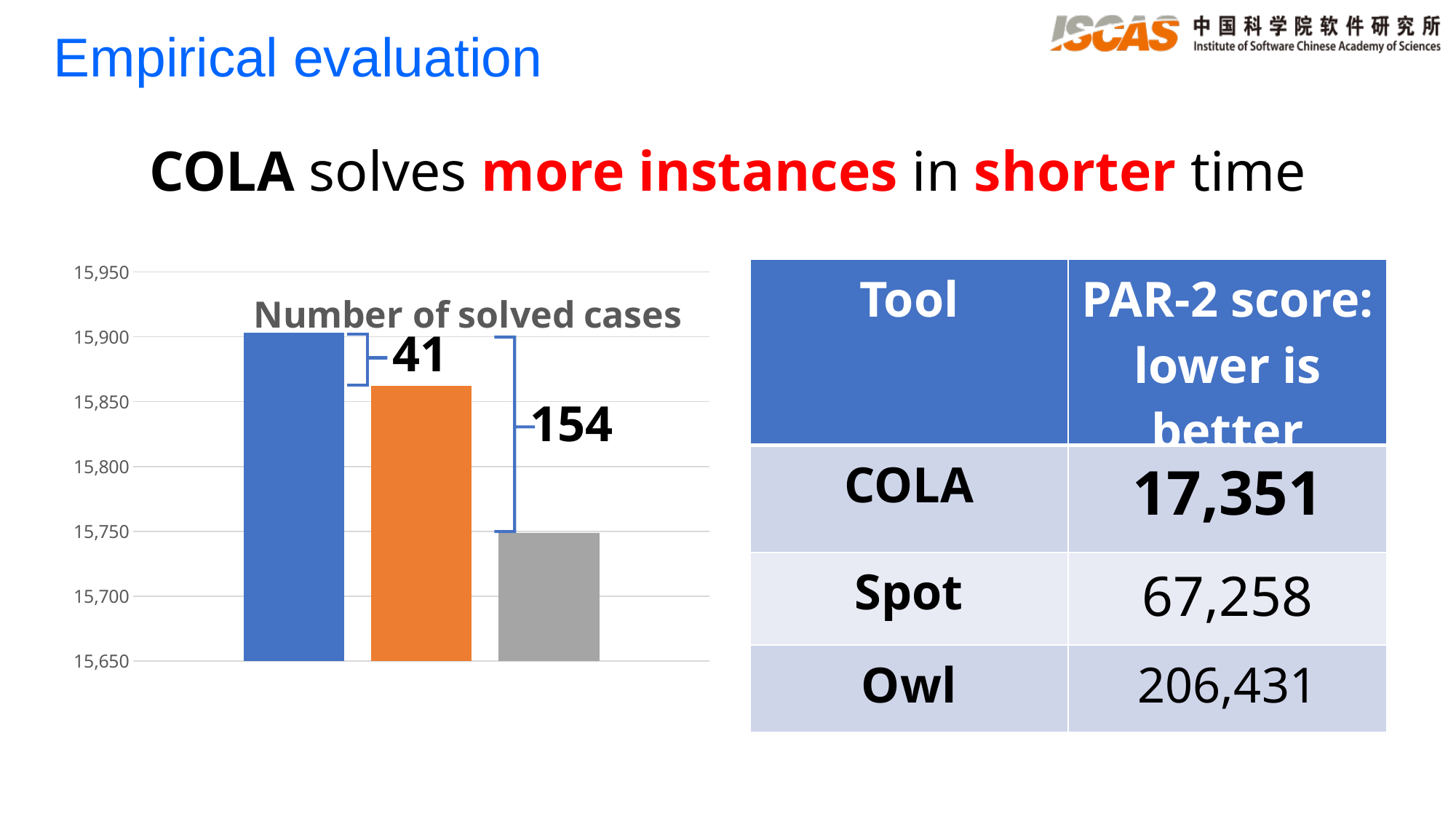
What is the title of the chart? Number of solved cases What kind of chart is shown on the slide? bar chart How many bars does the chart show? 3 Do the bar values rise or fall from left to right across the chart? fall Which bar has the larger value, the orange bar or the grey bar? orange According to the annotation on the chart, by how many solved cases does the blue bar exceed the orange bar? 41 Is the value of the grey bar greater or less than 15,800? less According to the annotation on the chart, by how many solved cases does the blue bar exceed the grey bar? 154 Is the value of the orange bar greater or less than 15,850? greater Which bar is the shortest in the chart: the blue, orange or grey one? grey Which bar is the tallest in the chart: the blue, orange or grey one? blue